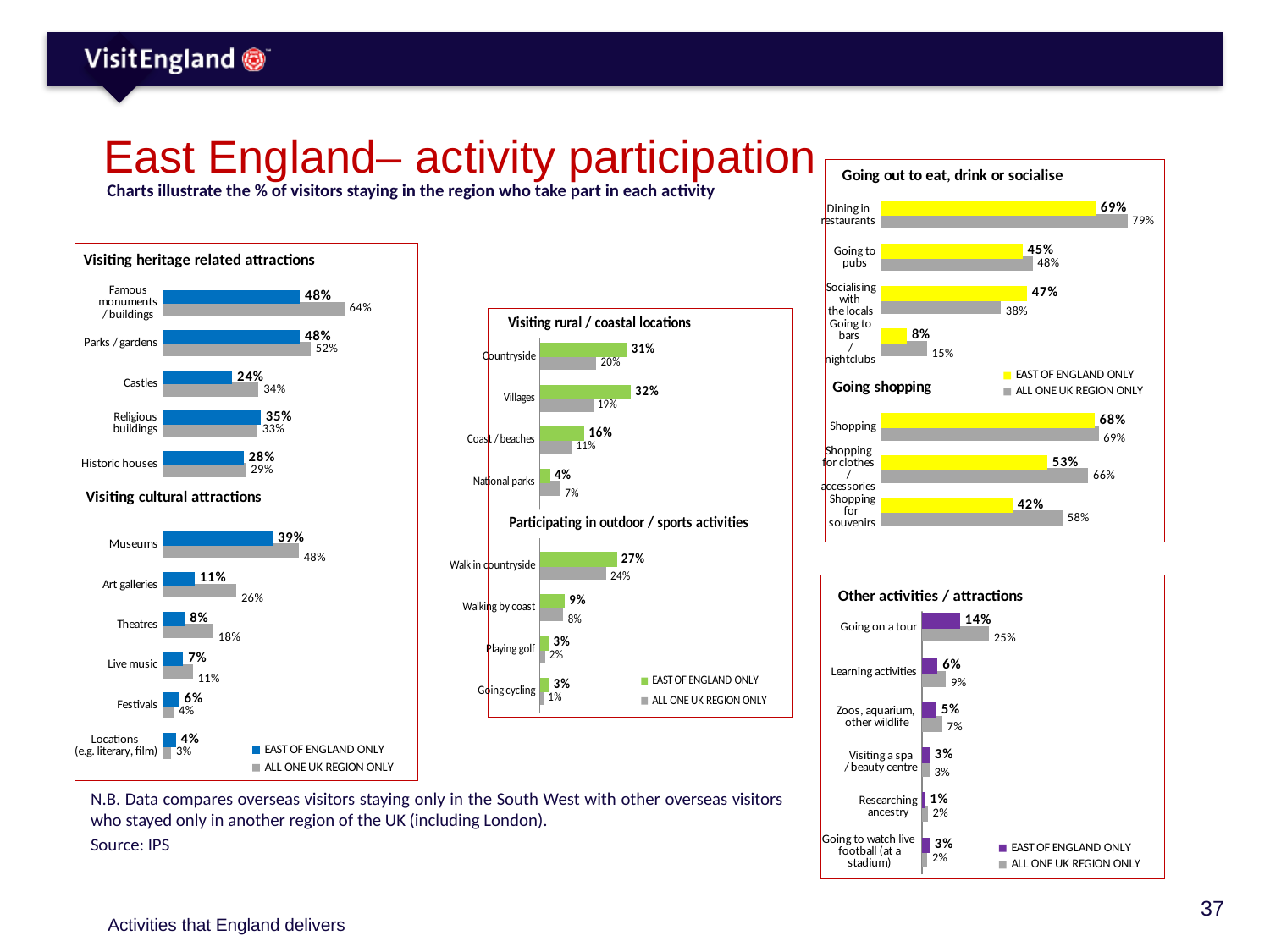
In the 'Going out to eat, drink or socialise' chart, what is the ALL ONE UK REGION ONLY value for Dining in restaurants? 79% In the 'Visiting rural / coastal locations' chart, which category has the lowest EAST OF ENGLAND ONLY value? National parks In the 'Visiting rural / coastal locations' chart, is the EAST OF ENGLAND ONLY value for Villages larger or smaller than the ALL ONE UK REGION ONLY value? larger In the 'Visiting cultural attractions' chart, what is the difference between the ALL ONE UK REGION ONLY and EAST OF ENGLAND ONLY values for Art galleries? 15% In the 'Visiting heritage related attractions' chart, what is the ALL ONE UK REGION ONLY value for Famous monuments / buildings? 64% How many series does the legend list in the 'Other activities / attractions' chart? 2 In the 'Visiting heritage related attractions' chart, what is the value for Castles for EAST OF ENGLAND ONLY? 24% In the 'Visiting cultural attractions' chart, which category has the highest EAST OF ENGLAND ONLY value? Museums In the 'Other activities / attractions' chart, what is the EAST OF ENGLAND ONLY value for Going on a tour? 14% In the 'Going shopping' chart, how many categories are shown? 3 In the 'Going out to eat, drink or socialise' chart, what is the difference between the EAST OF ENGLAND ONLY and ALL ONE UK REGION ONLY values for Socialising with the locals? 9% In the 'Participating in outdoor / sports activities' chart, what is the EAST OF ENGLAND ONLY value for Walk in countryside? 27%